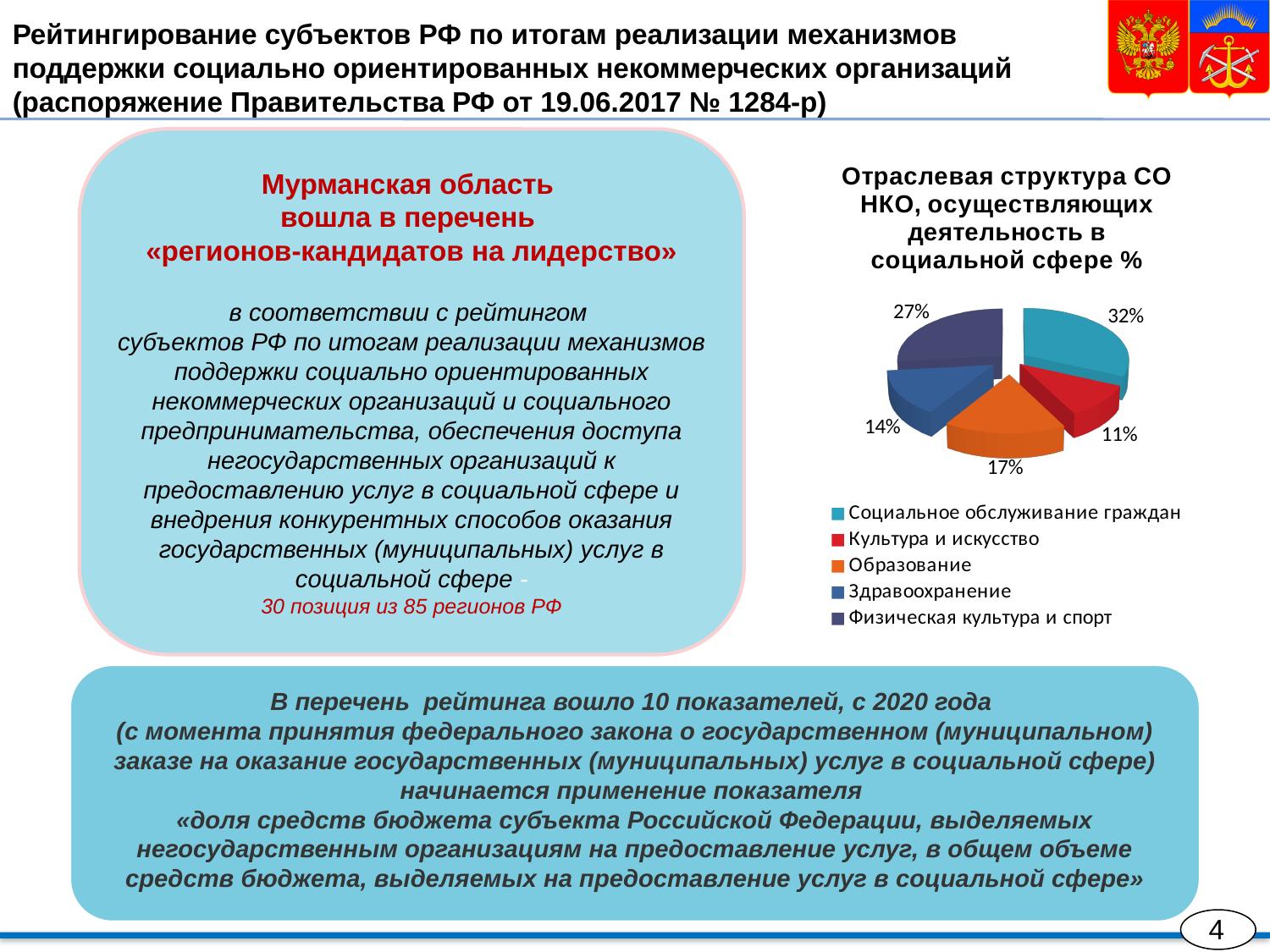
Which has a larger share: «Образование» or «Здравоохранение»? Образование What is the share of «Культура и искусство» in the pie chart? 11% What is the title of the pie chart? Отраслевая структура СО НКО, осуществляющих деятельность в социальной сфере % Which category has the smallest share in the pie chart? Культура и искусство What is the share of «Здравоохранение» in the pie chart? 14% How many categories does the pie chart show? 5 What is the share of «Социальное обслуживание граждан» in the pie chart? 32% What type of chart is shown on the slide? Pie chart What is the share of «Образование» in the pie chart? 17% What is the difference in percentage points between «Социальное обслуживание граждан» and «Физическая культура и спорт»? 5 What is the share of «Физическая культура и спорт» in the pie chart? 27% Which category has the largest share in the pie chart? Социальное обслуживание граждан